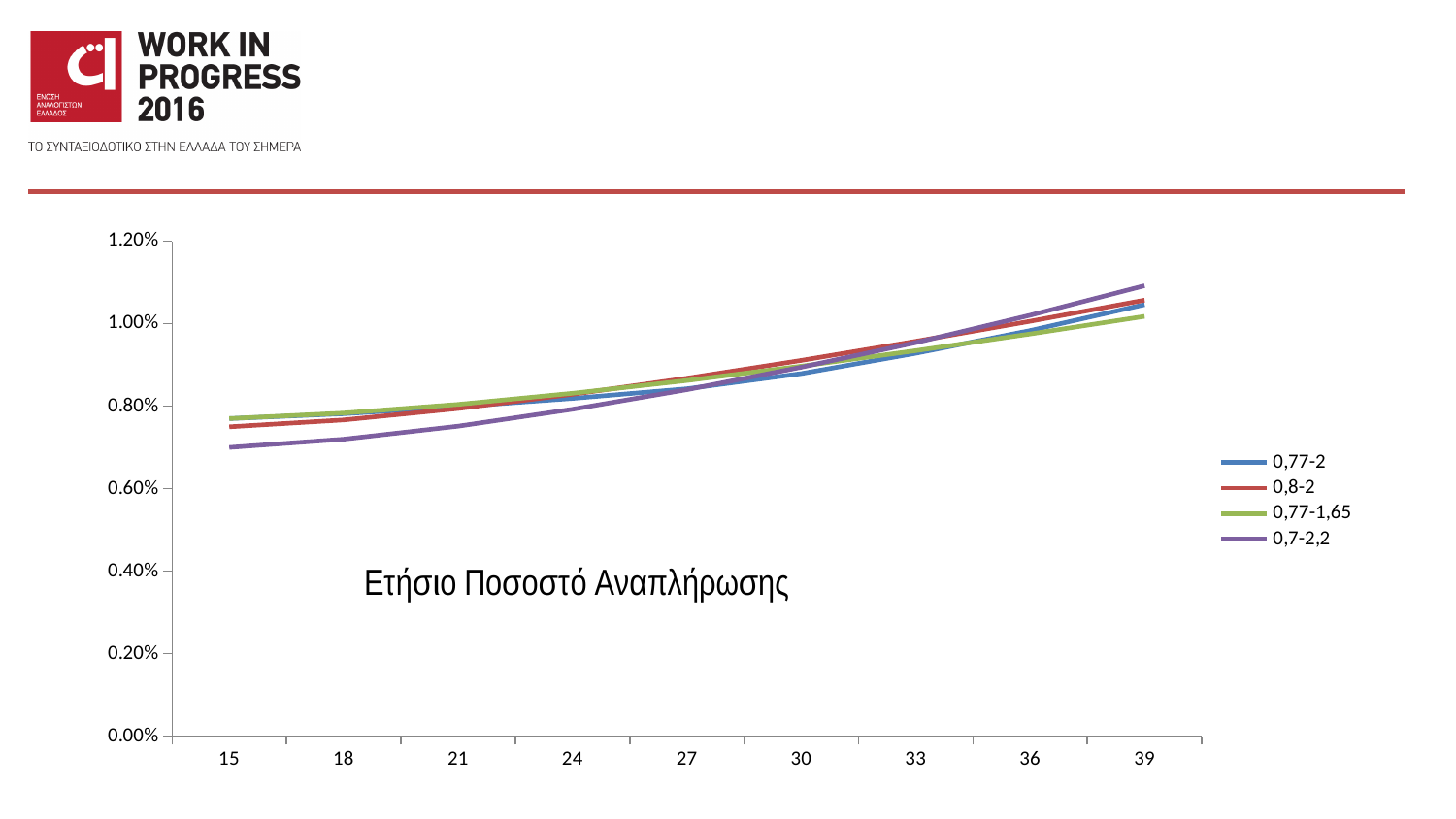
Which series is drawn in purple? 0,7-2,2 Is the value of the 0,77-1,65 series at x = 15 greater or less than 1.00%? less Which series has the highest value at x = 39? 0,7-2,2 How many series does the legend list? 4 What is the title shown on the chart? Ετήσιο Ποσοστό Αναπλήρωσης What kind of chart is shown on the slide? line chart Is the value of the 0,7-2,2 series at x = 39 greater or less than 1.00%? greater Which series has the lowest value at x = 15? 0,7-2,2 Do the values of the 0,7-2,2 series rise or fall as the x axis goes from 15 to 39? rise How many labelled points are on the x axis? 9 Is the value of the 0,7-2,2 series at x = 15 greater or less than 0.80%? less Do the values of the 0,8-2 series rise or fall along the x axis? rise